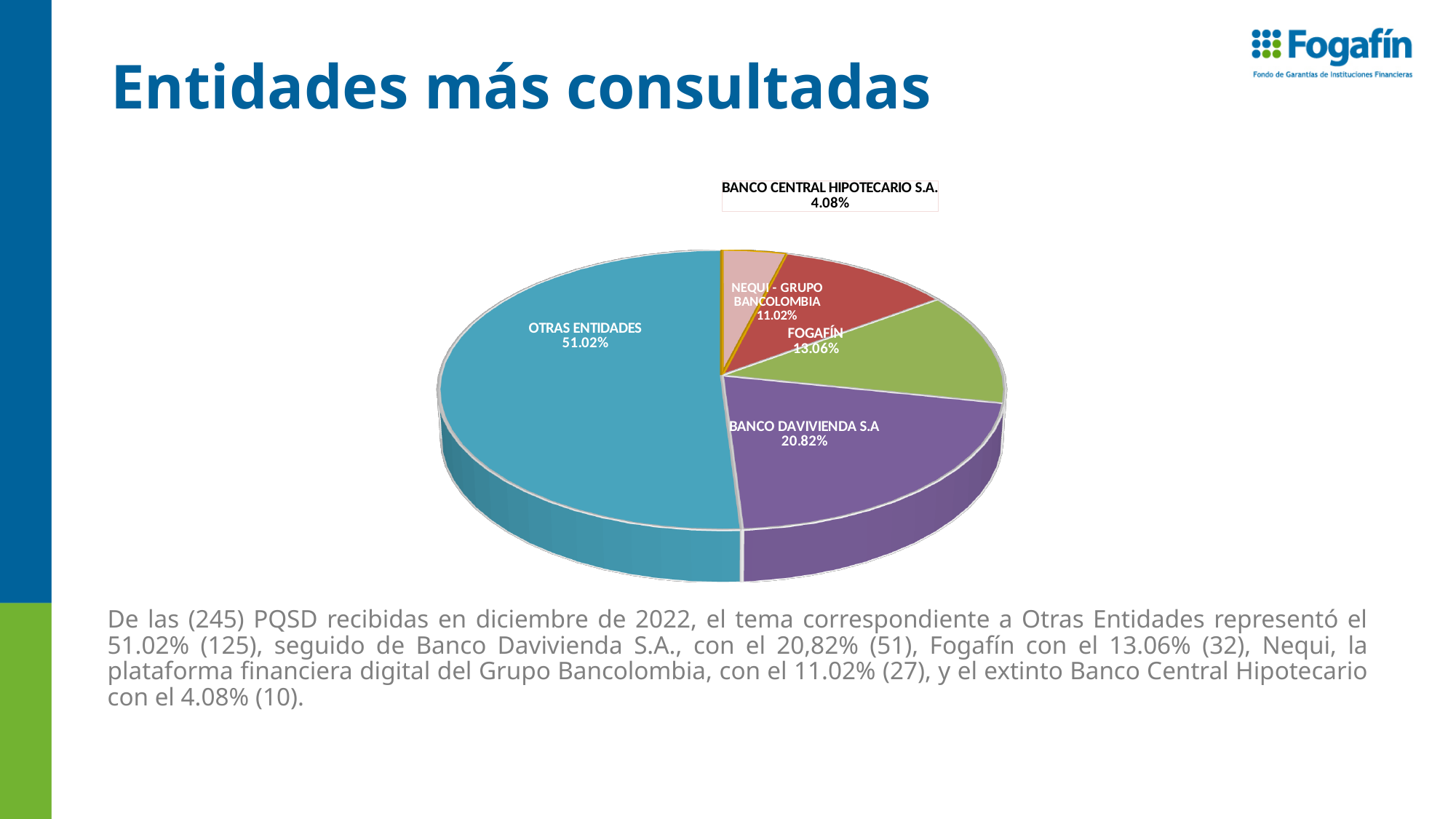
What percentage is shown for FOGAFÍN? 13.06% What percentage is shown for BANCO DAVIVIENDA S.A? 20.82% What kind of chart is shown on the slide? Pie chart What is the difference in percentage points between OTRAS ENTIDADES and BANCO DAVIVIENDA S.A? 30.20 What is the title of the slide containing the pie chart? Entidades más consultadas Which category has the smallest slice of the pie? BANCO CENTRAL HIPOTECARIO S.A. What share of the pie does OTRAS ENTIDADES represent? 51.02% Which category has the largest slice of the pie? OTRAS ENTIDADES What percentage is shown for BANCO CENTRAL HIPOTECARIO S.A.? 4.08% What percentage is shown for NEQUI - GRUPO BANCOLOMBIA? 11.02% How many slices does the pie chart have? 5 Which is larger, the share for FOGAFÍN or the share for NEQUI - GRUPO BANCOLOMBIA? FOGAFÍN